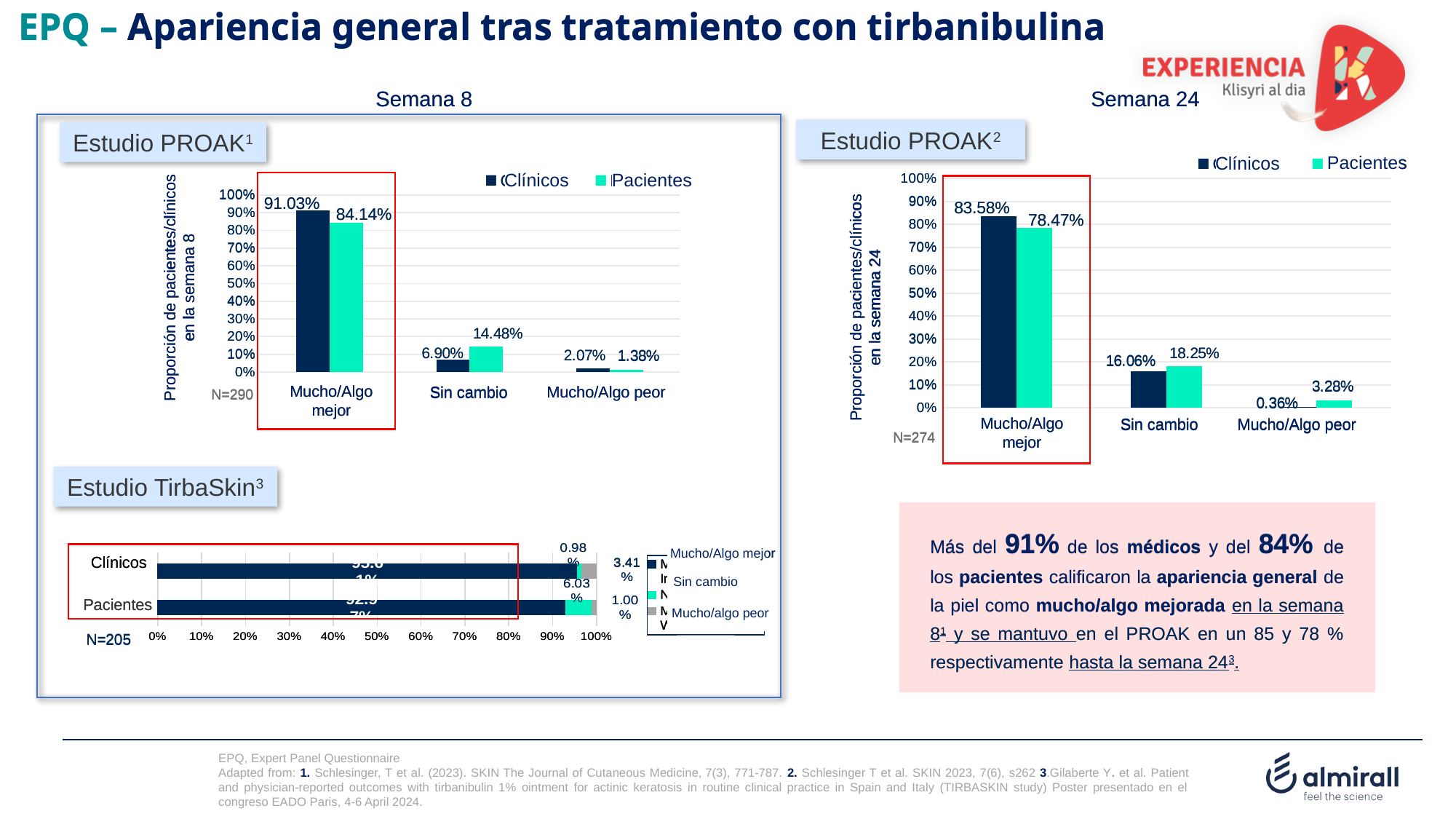
In the Estudio PROAK Semana 8 chart, which category has the highest value for Pacientes? Mucho/Algo mejor In the Estudio PROAK Semana 24 chart, what is the value for Clínicos in the Mucho/Algo peor category? 0.36% In the Estudio PROAK Semana 8 chart, what is the value for Clínicos in the Mucho/Algo mejor category? 91.03% In the Estudio PROAK Semana 24 chart, what is the difference between the Clínicos and Pacientes values for Mucho/Algo mejor? 5.11% In the Estudio PROAK Semana 24 chart, which is larger in the Sin cambio category, Clínicos or Pacientes? Pacientes In the Estudio PROAK Semana 24 chart, what is the value for Pacientes in the Mucho/Algo mejor category? 78.47% In the Estudio PROAK Semana 8 chart, what is the value for Pacientes in the Sin cambio category? 14.48% How many categories are shown on the x axis of the Estudio PROAK Semana 8 chart? 3 What type of chart is the Estudio TirbaSkin chart at the bottom left? Stacked bar chart In the Estudio PROAK Semana 24 chart, which category has the lowest value for Clínicos? Mucho/Algo peor In the Estudio PROAK Semana 8 chart, what is the difference between the Clínicos and Pacientes values for Mucho/Algo mejor? 6.89% How many series does the legend of the Estudio PROAK Semana 24 chart list? 2